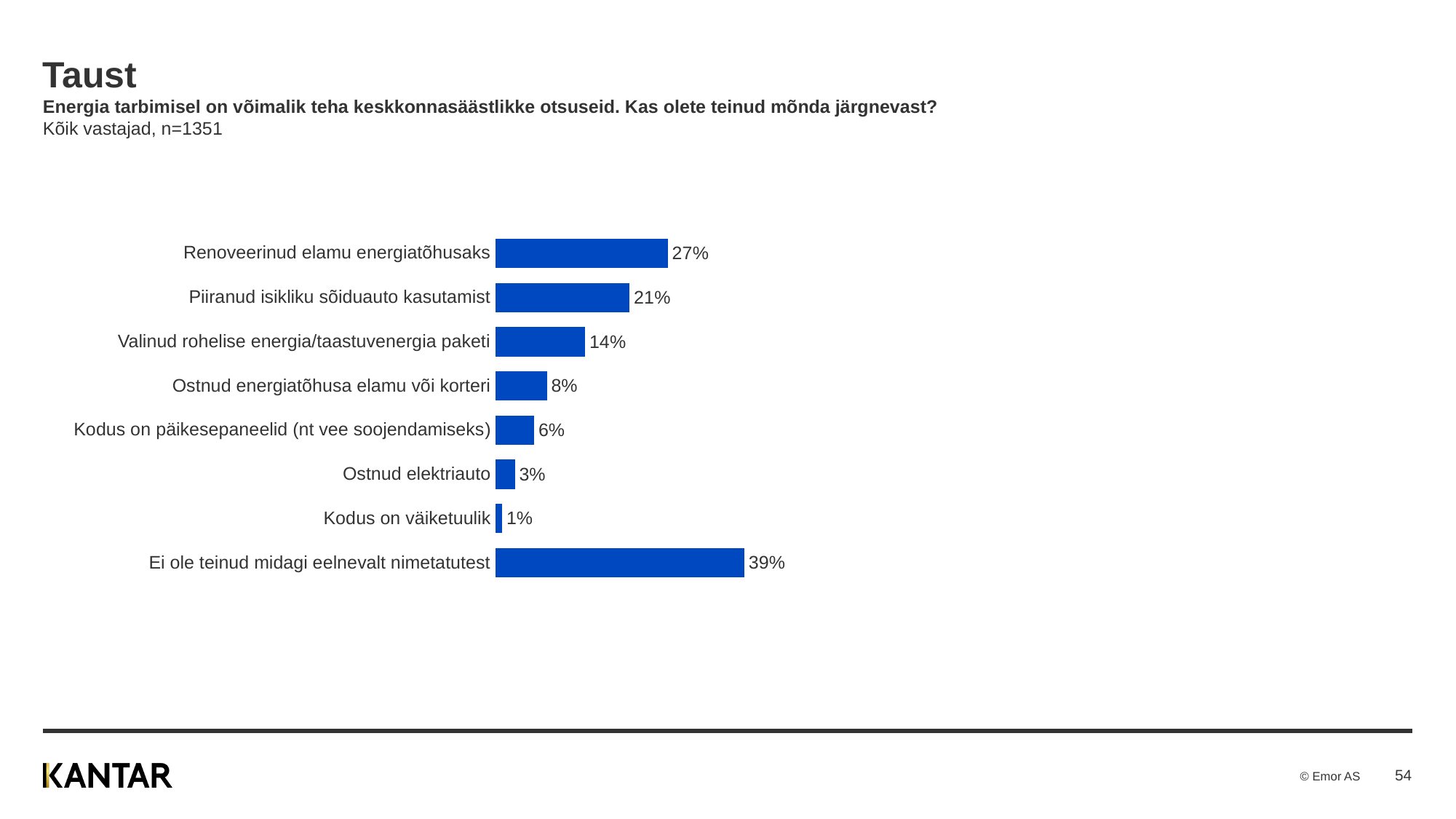
What is the difference between "Ei ole teinud midagi eelnevalt nimetatutest" and "Renoveerinud elamu energiatõhusaks"? 12% What is the value for "Ei ole teinud midagi eelnevalt nimetatutest"? 39% How many categories are shown in the chart? 8 What is the value for "Valinud rohelise energia/taastuvenergia paketi"? 14% What is the value for "Kodus on päikesepaneelid (nt vee soojendamiseks)"? 6% Which is larger: "Ostnud energiatõhusa elamu või korteri" or "Ostnud elektriauto"? Ostnud energiatõhusa elamu või korteri Which category has the lowest value? Kodus on väiketuulik Which category has the highest value? Ei ole teinud midagi eelnevalt nimetatutest What is the value for "Renoveerinud elamu energiatõhusaks"? 27% What is the sample size stated on the slide? n=1351 What kind of chart is shown on the slide? Bar chart What is the difference between "Renoveerinud elamu energiatõhusaks" and "Piiranud isikliku sõiduauto kasutamist"? 6%